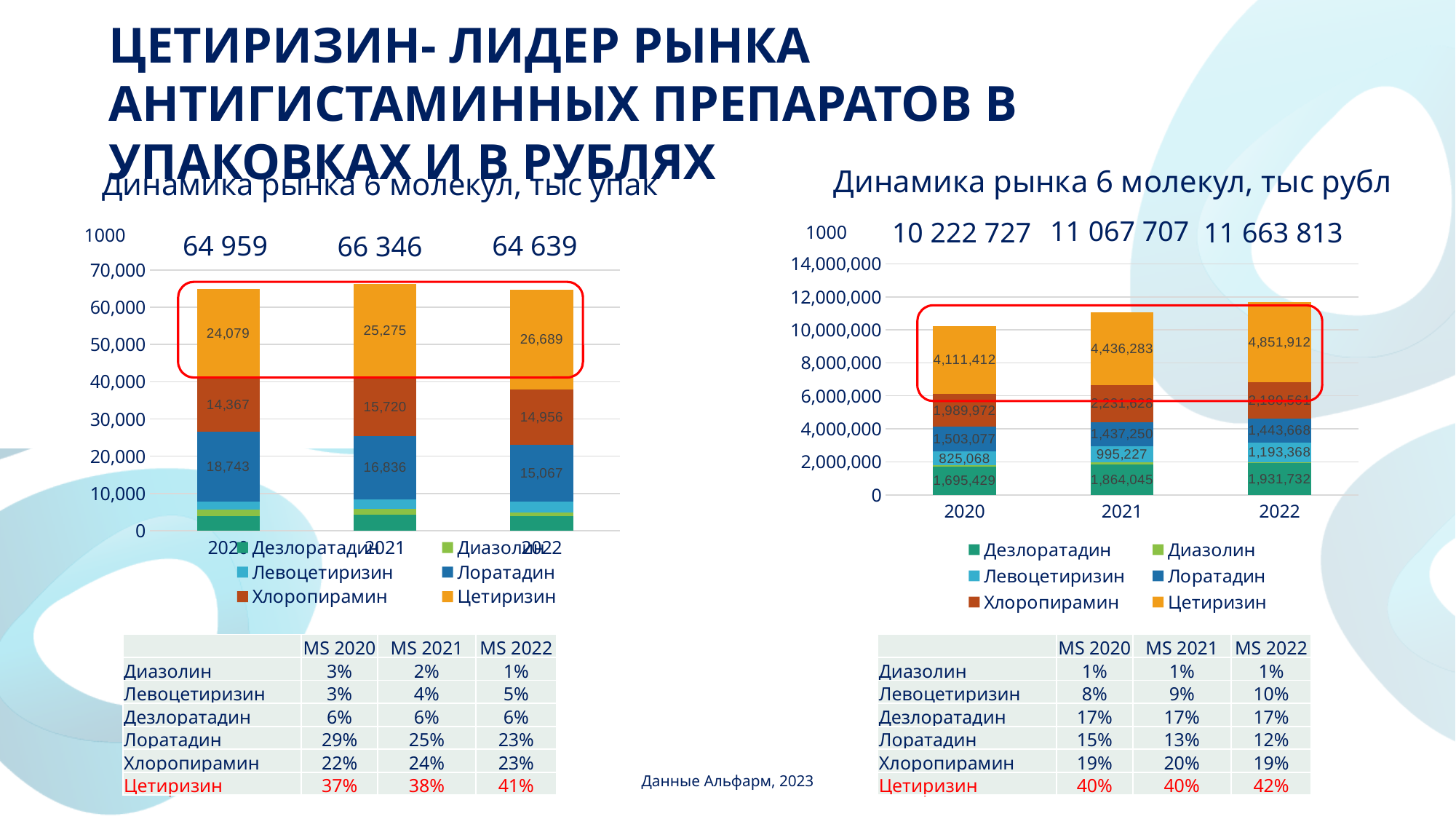
In the left chart (Динамика рынка 6 молекул, тыс упак), what is the value for Лоратадин in 2020? 18,743 In the left chart (Динамика рынка 6 молекул, тыс упак), which year has the highest total? 2021 How many series does the legend of the right chart (Динамика рынка 6 молекул, тыс рубл) list? 6 In the left chart (Динамика рынка 6 молекул, тыс упак), does the Лоратадин value rise or fall from 2020 to 2022? fall In the left chart (Динамика рынка 6 молекул, тыс упак), what is the value for Цетиризин in 2022? 26,689 In the left chart (Динамика рынка 6 молекул, тыс упак), what is the total shown above the 2021 bar? 66 346 In the left chart (Динамика рынка 6 молекул, тыс упак), what is the difference between the Цетиризин values for 2022 and 2020? 2,610 In the right chart (Динамика рынка 6 молекул, тыс рубл), what is the total shown above the 2022 bar? 11 663 813 In the right chart (Динамика рынка 6 молекул, тыс рубл), which is larger in 2020: Левоцетиризин or Лоратадин? Лоратадин What kind of chart is the left chart (Динамика рынка 6 молекул, тыс упак)? stacked bar chart In the right chart (Динамика рынка 6 молекул, тыс рубл), what is the value for Дезлоратадин in 2022? 1,931,732 In the right chart (Динамика рынка 6 молекул, тыс рубл), what is the value for Цетиризин in 2021? 4,436,283